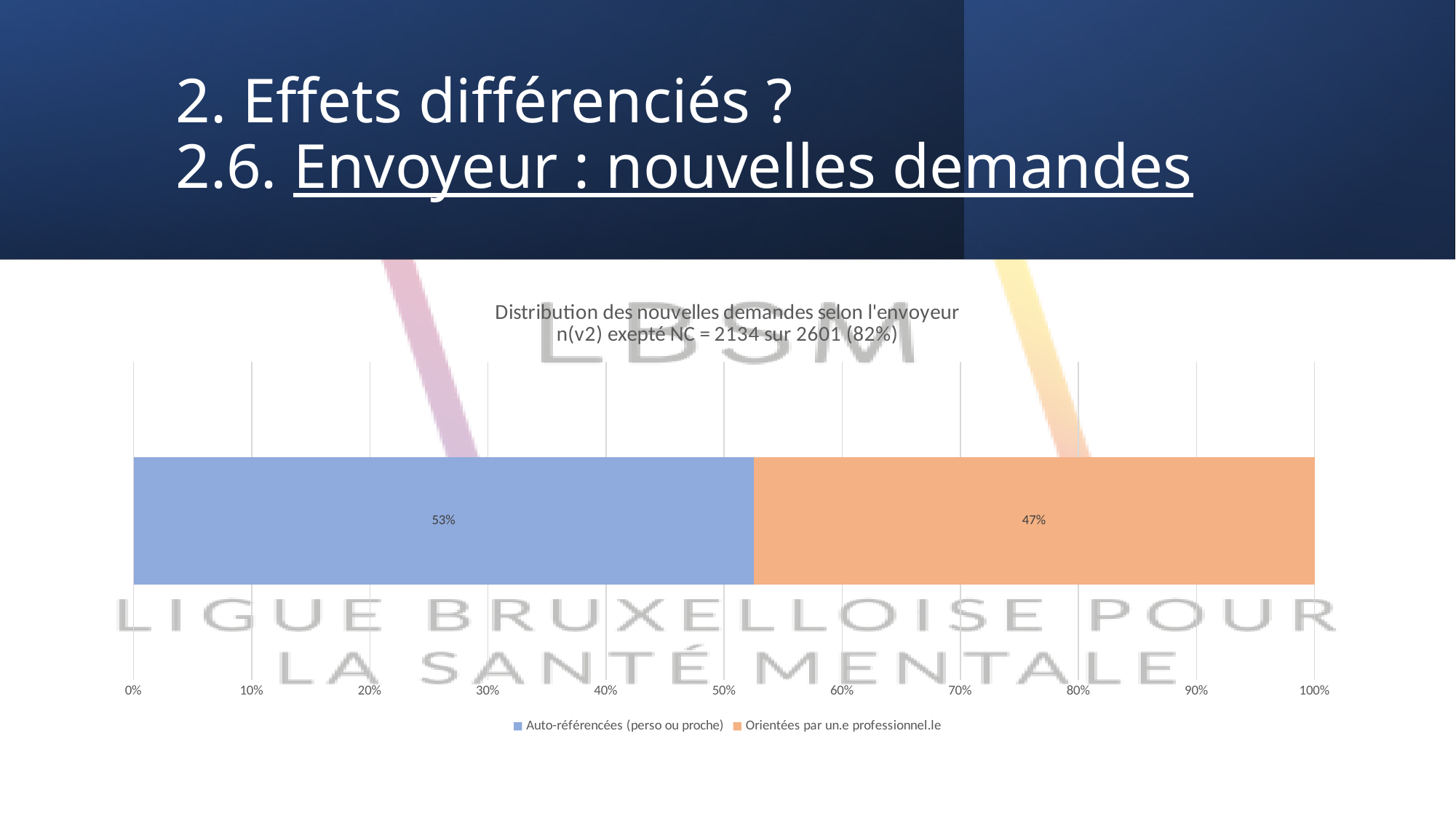
Is the value for 'Orientées par un.e professionnel.le' greater or less than 50%? less What is the difference in percentage points between the 'Auto-référencées (perso ou proche)' share and the 'Orientées par un.e professionnel.le' share? 6 percentage points What colour is the 'Orientées par un.e professionnel.le' segment? Orange Which series has the smallest share? Orientées par un.e professionnel.le What is the total of the two segments in the stacked bar? 100% How many series does the legend list? 2 Which series has the larger share: 'Auto-référencées (perso ou proche)' or 'Orientées par un.e professionnel.le'? Auto-référencées (perso ou proche) What kind of chart is shown on the slide? Stacked bar chart Is the value for 'Auto-référencées (perso ou proche)' greater or less than 50%? greater What is the title of the chart? Distribution des nouvelles demandes selon l'envoyeur n(v2) exepté NC = 2134 sur 2601 (82%) What percentage of new requests are 'Orientées par un.e professionnel.le'? 47% What percentage of new requests are 'Auto-référencées (perso ou proche)'? 53%